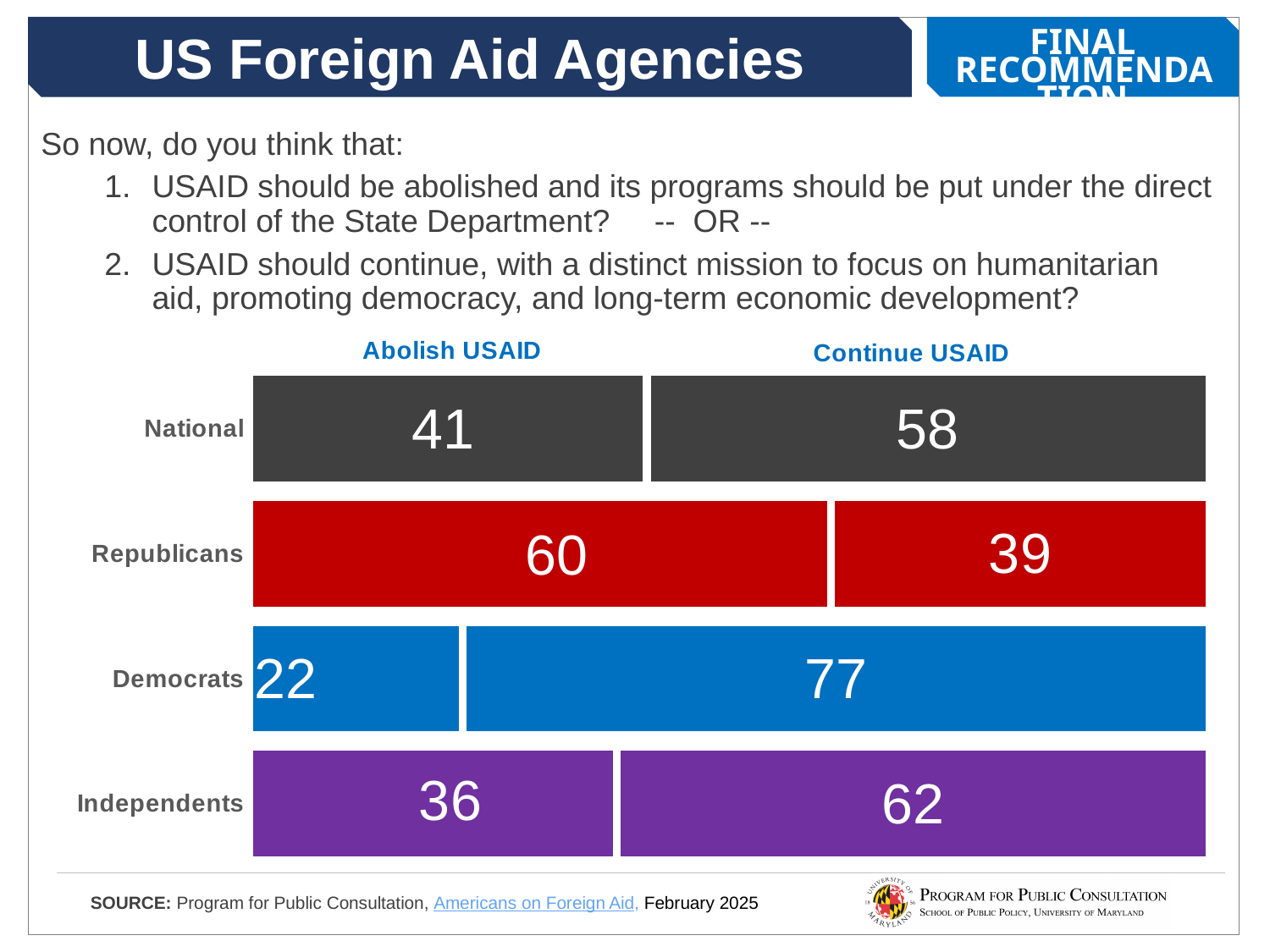
What is the Continue USAID value for Democrats? 77 Which group has the highest Continue USAID value? Democrats How many response options are shown for each group? 2 What is the Continue USAID value for Independents? 62 What is the National value for Abolish USAID? 41 What is the difference between the Continue USAID and Abolish USAID values for Republicans? 21 Which group has the lowest Abolish USAID value? Democrats What is the total of the Abolish USAID and Continue USAID values for Democrats? 99 What kind of chart is shown on the slide? Bar chart How many groups are shown in the chart? 4 Which is larger for Independents: Abolish USAID or Continue USAID? Continue USAID What is the Abolish USAID value for Republicans? 60